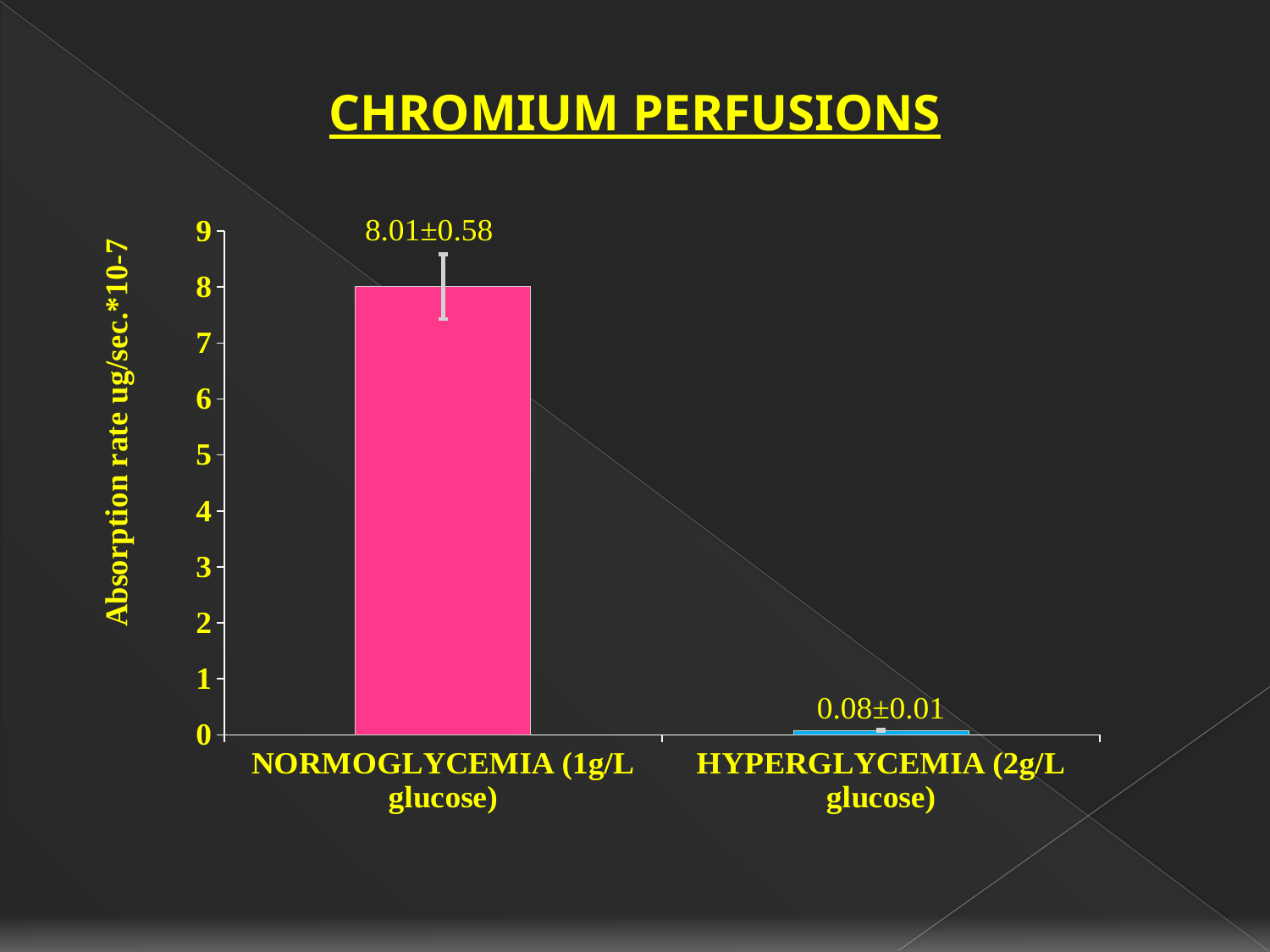
Is the absorption rate for HYPERGLYCEMIA (2g/L glucose) greater or less than 1? less Which is larger, the absorption rate for NORMOGLYCEMIA or for HYPERGLYCEMIA? NORMOGLYCEMIA What is the label of the y axis? Absorption rate ug/sec.*10-7 What is the absorption rate for NORMOGLYCEMIA (1g/L glucose)? 8.01±0.58 What is the highest value shown on the y axis? 9 What kind of chart is shown on the slide? bar chart What is the absorption rate for HYPERGLYCEMIA (2g/L glucose)? 0.08±0.01 Which condition has the lowest absorption rate? HYPERGLYCEMIA (2g/L glucose) How many categories are shown on the x axis? 2 What is the title of the chart? CHROMIUM PERFUSIONS Which condition has the highest absorption rate? NORMOGLYCEMIA (1g/L glucose) Is the absorption rate for NORMOGLYCEMIA (1g/L glucose) greater or less than 5? greater